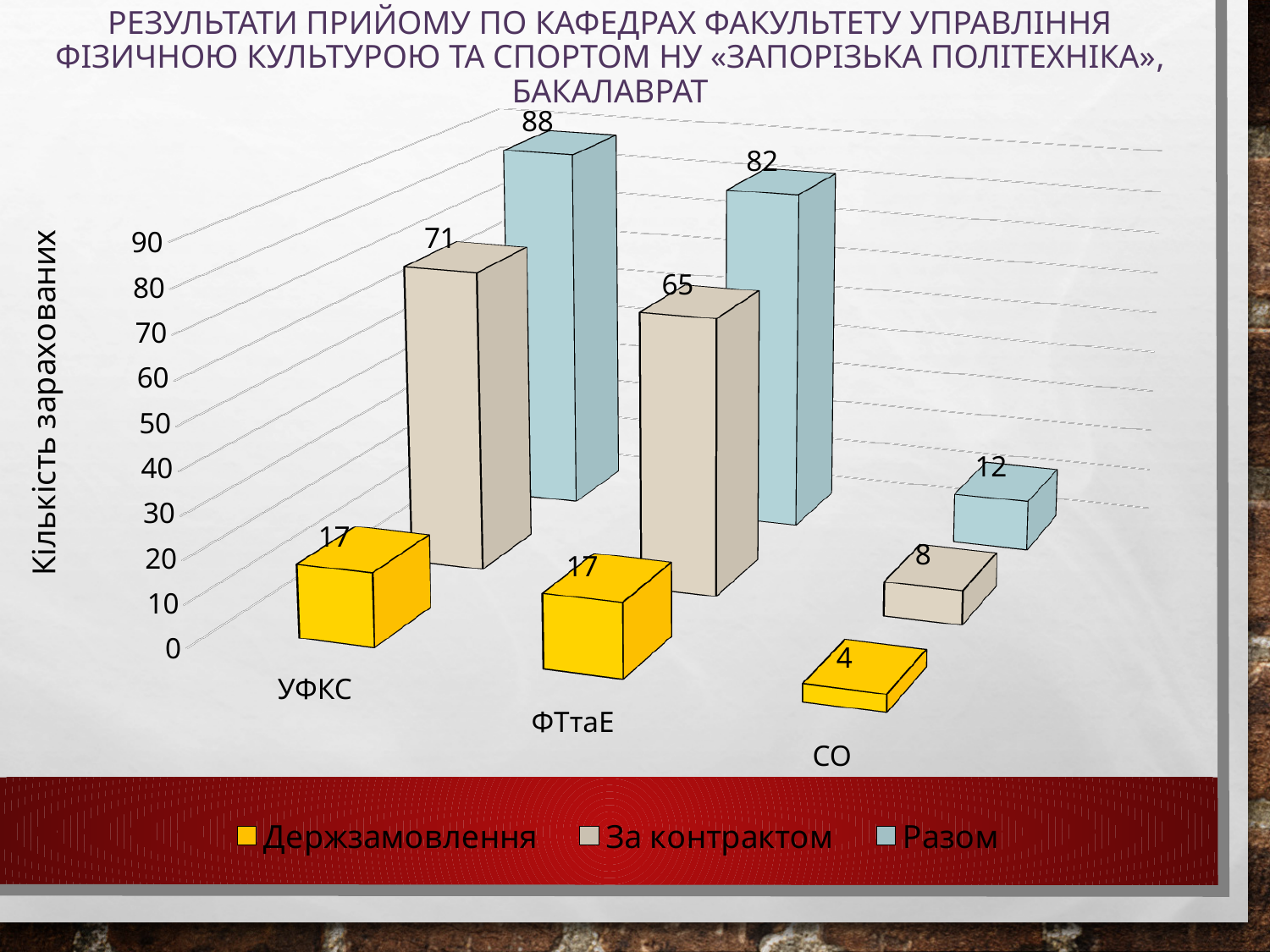
What is the value of Держзамовлення for СО? 4 Which is larger, the За контрактом value for УФКС or for ФТтаЕ? УФКС How many categories are shown on the x axis? 3 What is the value of Разом for УФКС? 88 What is the difference between the Разом values for УФКС and ФТтаЕ? 6 How many series does the legend list? 3 What is the value of За контрактом for ФТтаЕ? 65 Which category has the lowest За контрактом value? СО What kind of chart is shown on the slide? Bar chart Which category has the highest Разом value? УФКС What is the label of the vertical axis? Кількість зарахованих Which series is shown in yellow? Держзамовлення